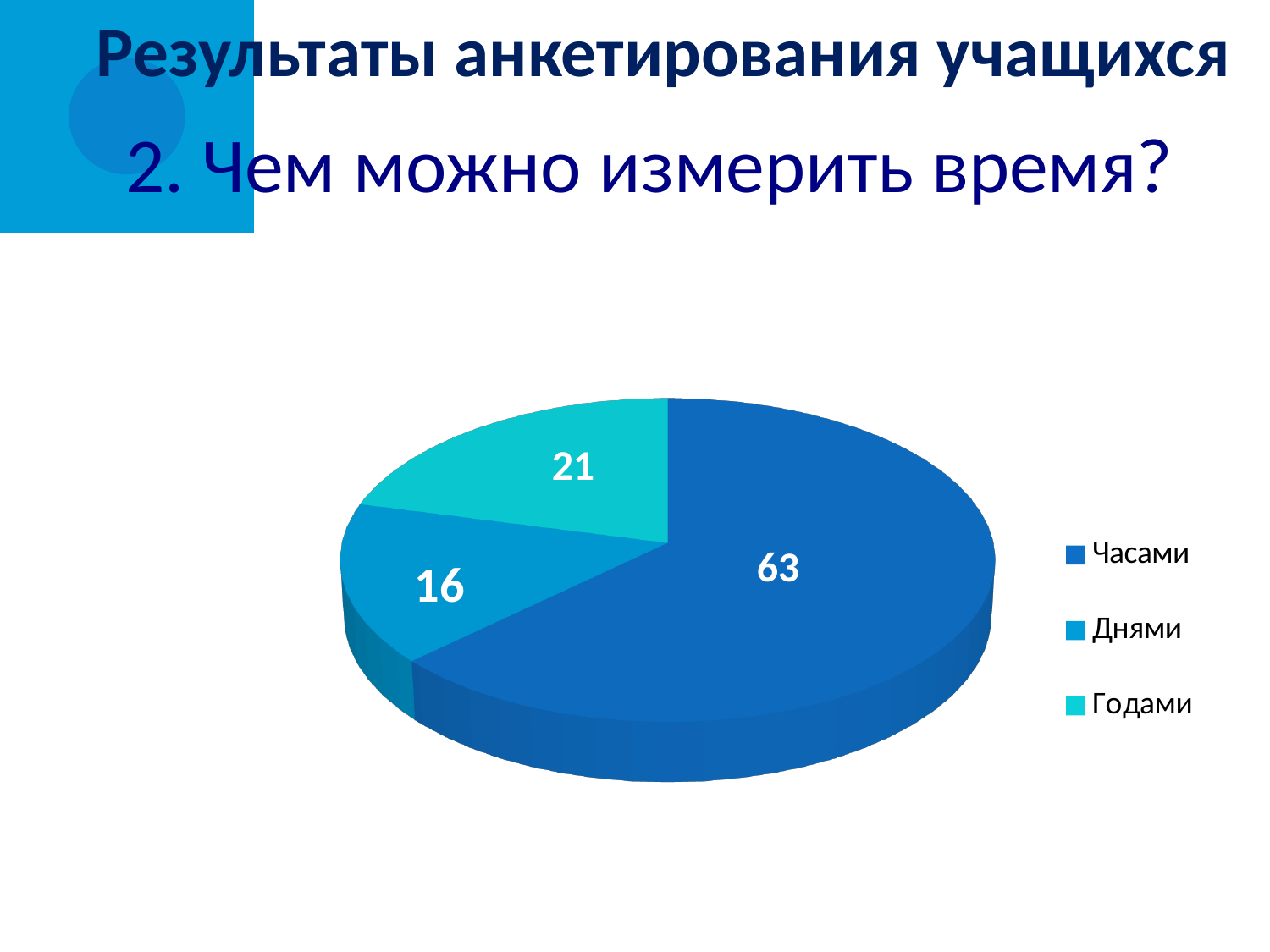
What share of the pie does the Часами slice represent? 63% What kind of chart is shown on the slide? pie chart What is the value for Днями? 16 What is the value for Годами? 21 Which category has the smallest slice of the pie? Днями What is the value for Часами? 63 Which is larger, the value for Годами or the value for Днями? Годами What is the difference between the values for Годами and Днями? 5 How many slices does the pie chart have? 3 Which category has the largest slice of the pie? Часами What is the question shown above the chart? 2. Чем можно измерить время? What is the difference between the values for Часами and Годами? 42